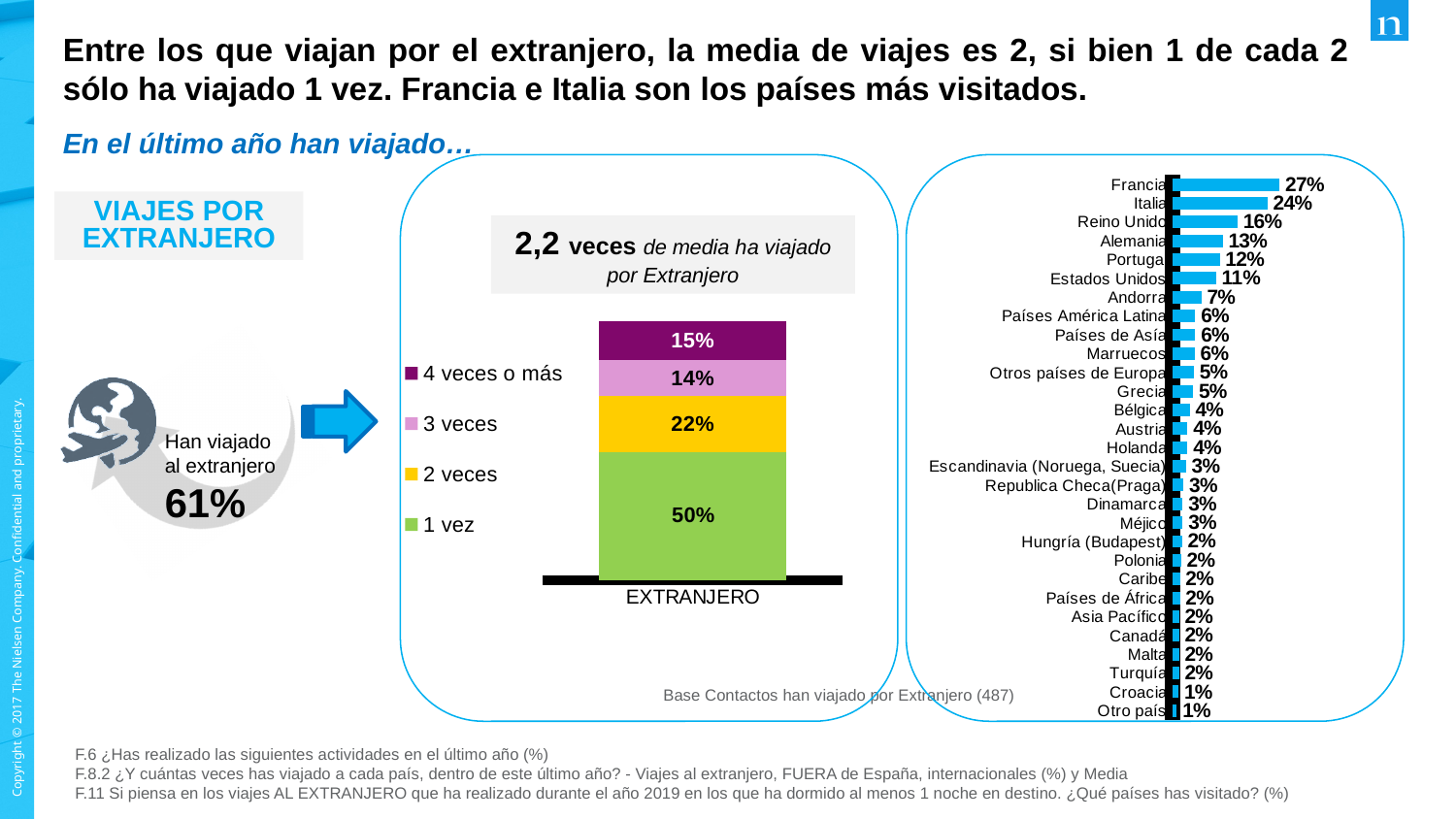
In the stacked bar chart labelled EXTRANJERO, what percentage corresponds to '3 veces'? 14% In the country bar chart on the right, which is larger, Reino Unido or Alemania? Reino Unido What kind of chart is the country chart on the right? Bar chart In the country bar chart on the right, what is the difference between Francia and Italia? 3% In the country bar chart on the right, which country has the highest value? Francia In the stacked bar chart labelled EXTRANJERO, which segment is the largest? 1 vez In the country bar chart on the right, what is the value for Portugal? 12% In the stacked bar chart labelled EXTRANJERO, what percentage corresponds to '1 vez'? 50% In the country bar chart on the right, what is the value for Francia? 27% In the stacked bar chart labelled EXTRANJERO, how many series does the legend list? 4 In the stacked bar chart labelled EXTRANJERO, what is the total of all segments? 101% In the stacked bar chart labelled EXTRANJERO, what is the difference between the '2 veces' and '3 veces' segments? 8%